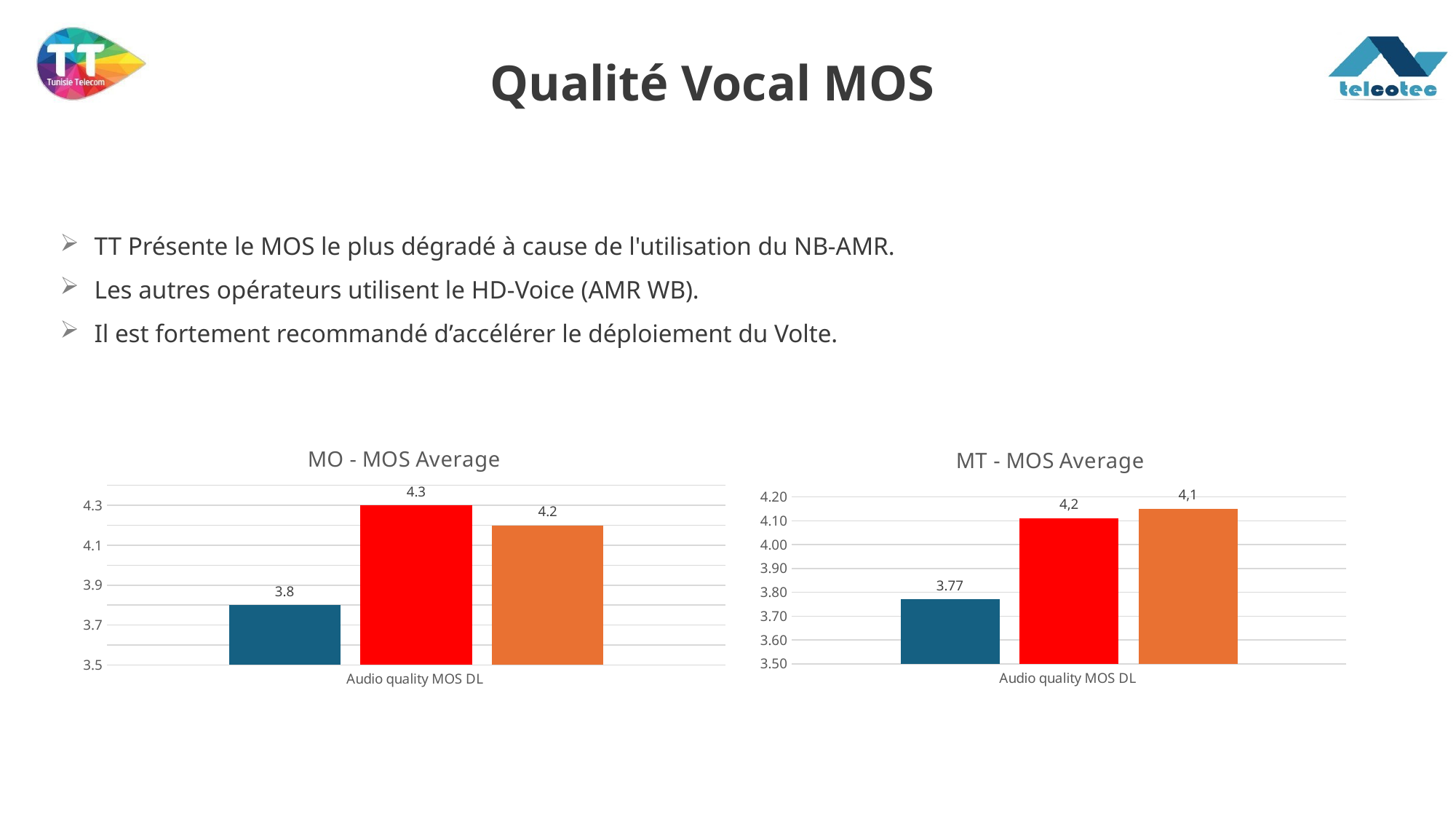
In the MT - MOS Average chart, what is the value shown on the blue bar? 3.77 In the MO - MOS Average chart, what is the value shown on the red bar? 4.3 In the MO - MOS Average chart, what is the value shown on the orange bar? 4.2 In the MT - MOS Average chart, what is the value shown on the red bar? 4,2 What is the x-axis category label shown under the bars in the MO - MOS Average chart? Audio quality MOS DL In the MT - MOS Average chart, which coloured bar is the lowest? the blue bar In the MO - MOS Average chart, is the blue bar greater or less than 3.9? less What kind of chart is the MT - MOS Average chart? bar chart In the MT - MOS Average chart, what is the value shown on the orange bar? 4,1 In the MO - MOS Average chart, what is the difference between the red bar and the blue bar? 0.5 In the MO - MOS Average chart, which coloured bar is the highest? the red bar In the MO - MOS Average chart, what is the value shown on the blue bar? 3.8